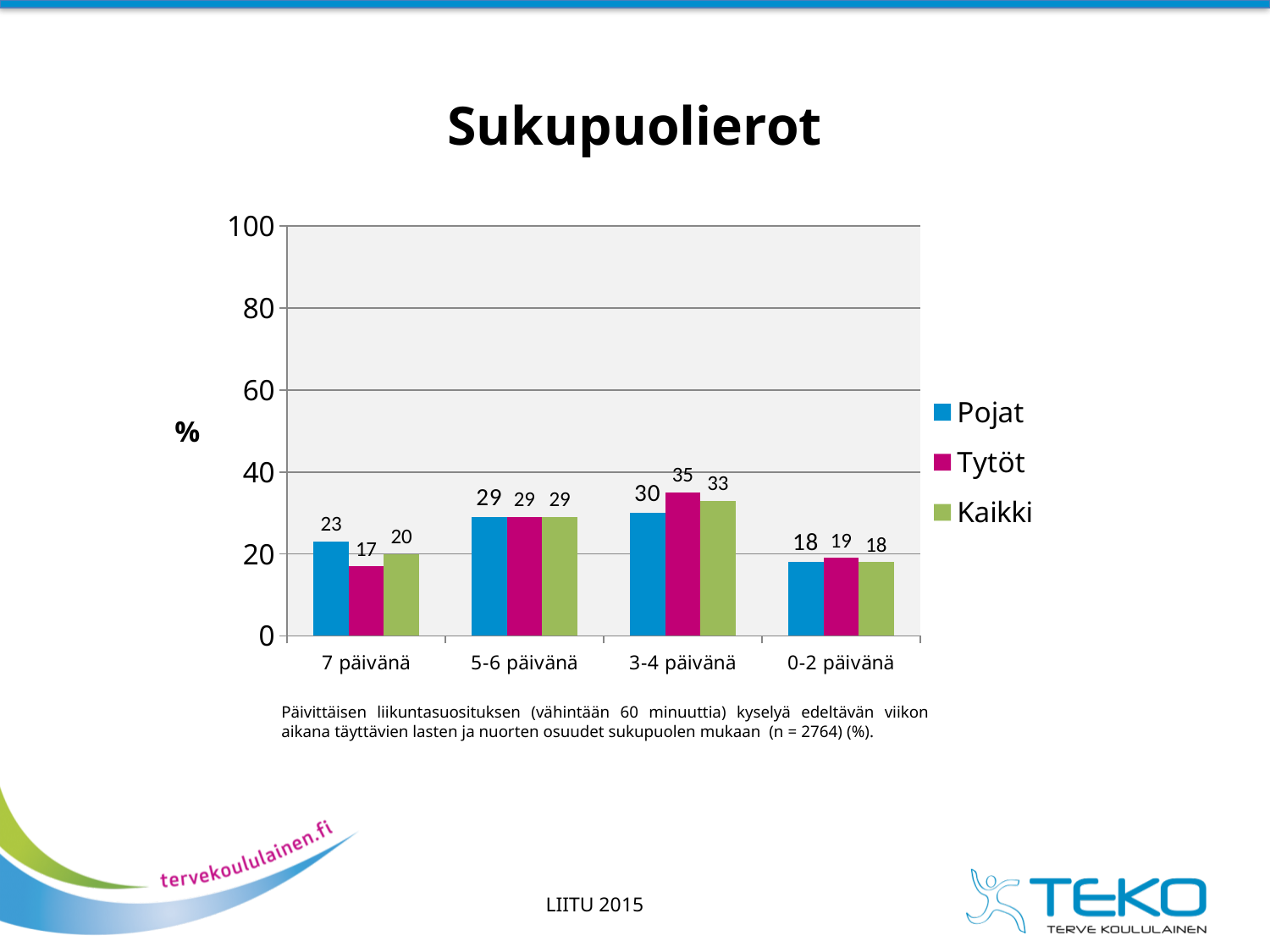
How many categories are shown on the x axis? 4 What is the difference between the Pojat and Tytöt values in the 7 päivänä category? 6 Which category has the highest value for Tytöt? 3-4 päivänä In the 3-4 päivänä category, which is larger, the Pojat value or the Tytöt value? Tytöt Is the value for Kaikki in the 3-4 päivänä category greater or less than 40? less Which category has the lowest value for Pojat? 0-2 päivänä What is the value for Pojat in the 7 päivänä category? 23 How many series does the legend list? 3 What is the value for Tytöt in the 3-4 päivänä category? 35 What is the title of the chart? Sukupuolierot What kind of chart is shown on the slide? bar chart What is the value for Kaikki in the 0-2 päivänä category? 18